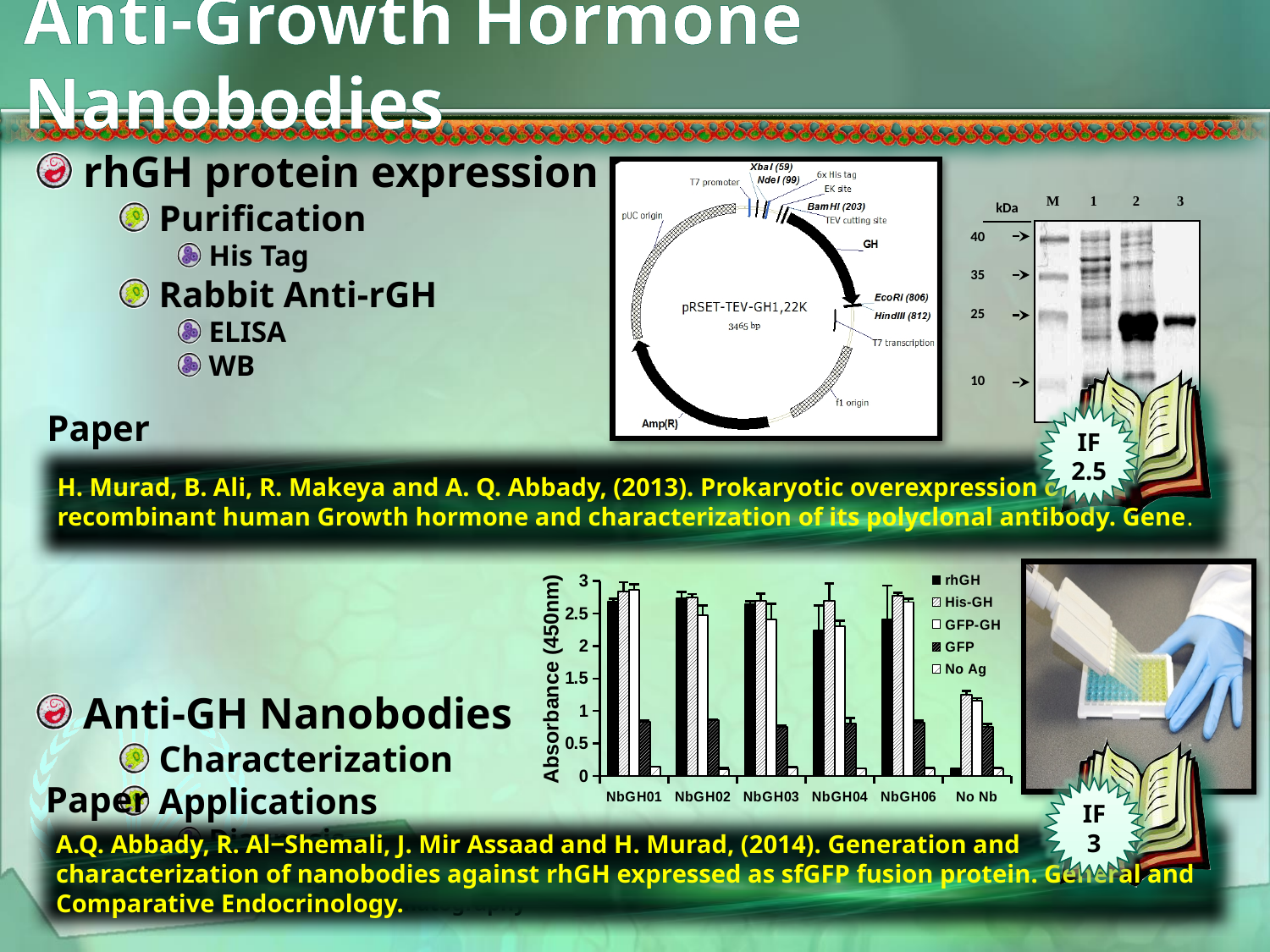
What kind of chart is shown on the slide? bar chart Which category has the lowest rhGH value? No Nb What is the label of the y axis of the bar chart? Absorbance (450nm) Is the GFP value for NbGH01 greater or less than 1? less Is the rhGH value for No Nb greater or less than 0.5? less Which series is listed first in the legend of the bar chart? rhGH Which is larger, the rhGH value for NbGH01 or the rhGH value for No Nb? NbGH01 Which is larger for NbGH03, the GFP value or the No Ag value? GFP Is the rhGH value for NbGH01 greater or less than 2.5? greater How many series does the legend of the bar chart list? 5 How many categories are shown along the x axis of the bar chart? 6